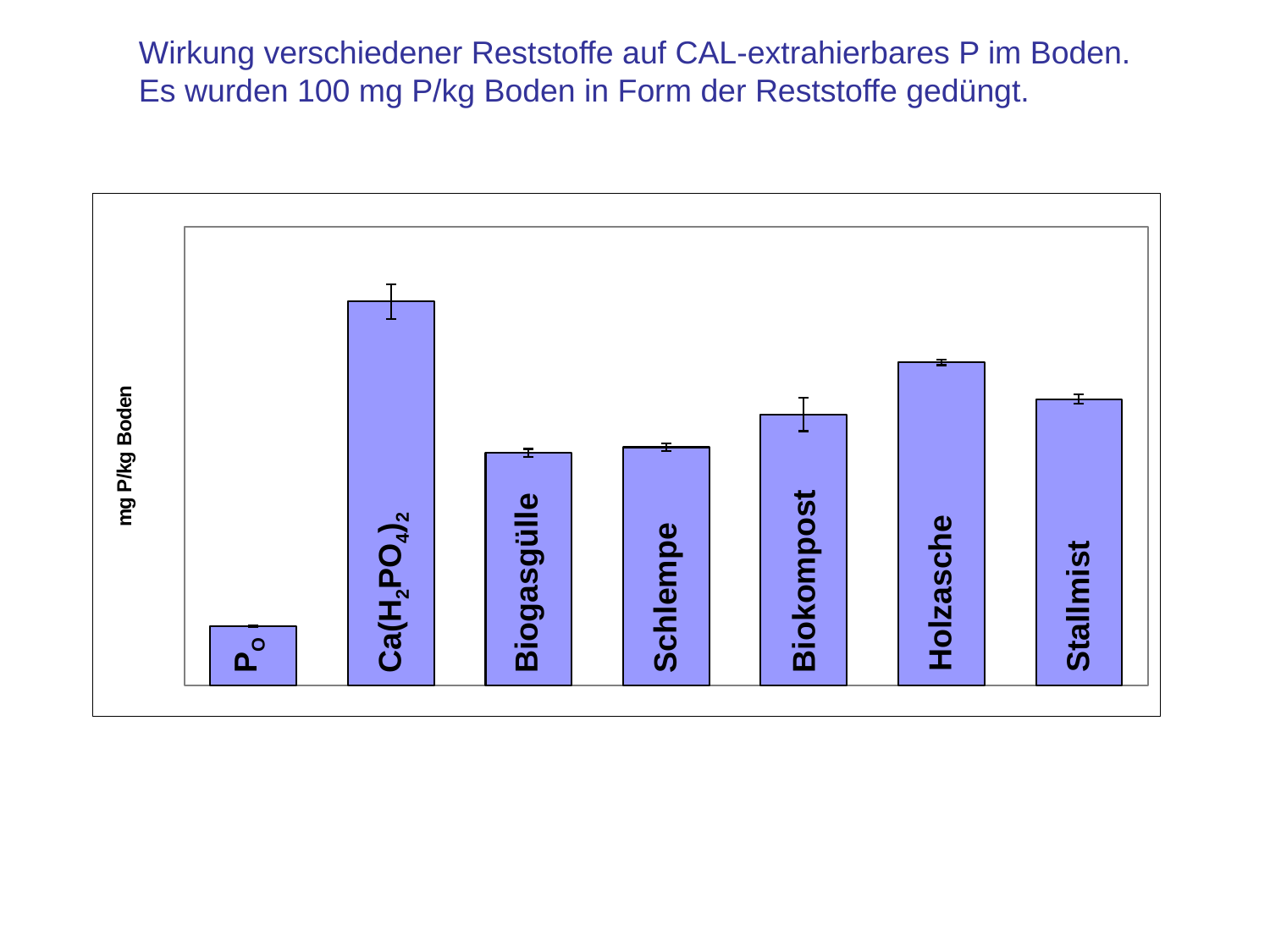
Which is larger, the value for Biokompost or the value for Schlempe? Biokompost Which is larger, the value for Ca(H2PO4)2 or the value for Holzasche? Ca(H2PO4)2 According to the slide title, how much P per kg soil was applied in the form of the residues? 100 mg P/kg Boden What kind of chart is shown on the slide? bar chart Which is larger, the value for Stallmist or the value for Biokompost? Stallmist Which category has the second highest bar in the chart? Holzasche Which category has the highest value in the chart? Ca(H2PO4)2 Which category has the lowest value in the chart? P0 What is the label of the y axis of the chart? mg P/kg Boden How many bars (categories) are shown in the chart? 7